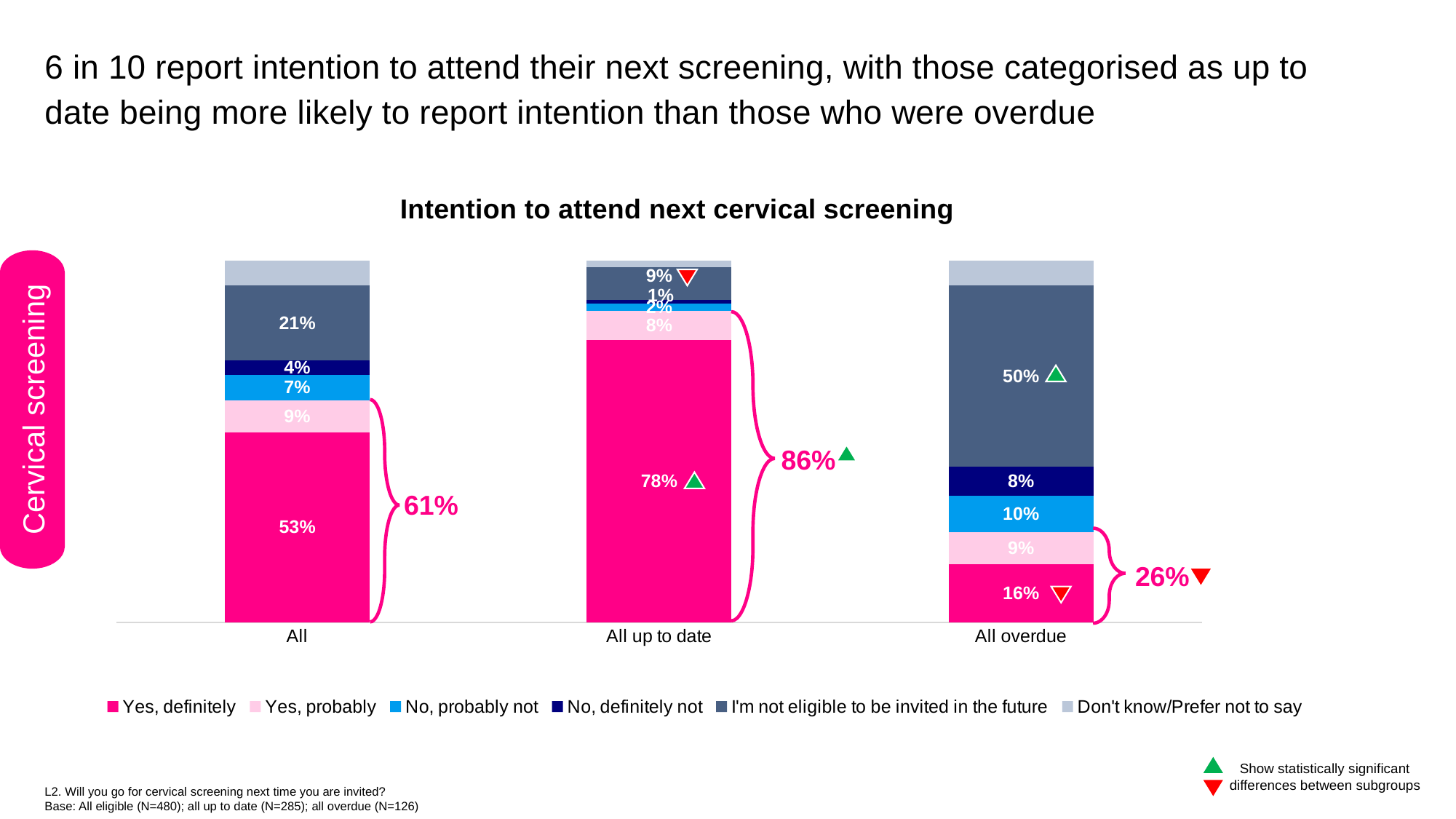
What kind of chart is shown on the slide? Stacked bar chart What percentage of the 'All' group answered 'Yes, definitely'? 53% What percentage of the 'All up to date' group answered 'Yes, definitely'? 78% What is the combined 'Yes' (definitely or probably) percentage shown by the bracket for the 'All overdue' group? 26% How many groups (bars) are shown on the x axis? 3 How many series does the legend list? 6 Which group has the lowest 'Yes, definitely' percentage? All overdue What is the difference in 'Yes, definitely' percentage between 'All up to date' and 'All overdue'? 62 percentage points What is the combined 'Yes' percentage shown by the bracket for the 'All up to date' group? 86% Which is larger: the 'No, probably not' share for 'All' or for 'All overdue'? All overdue Which group has the highest 'Yes, definitely' percentage? All up to date What percentage of the 'All overdue' group said 'I'm not eligible to be invited in the future'? 50%